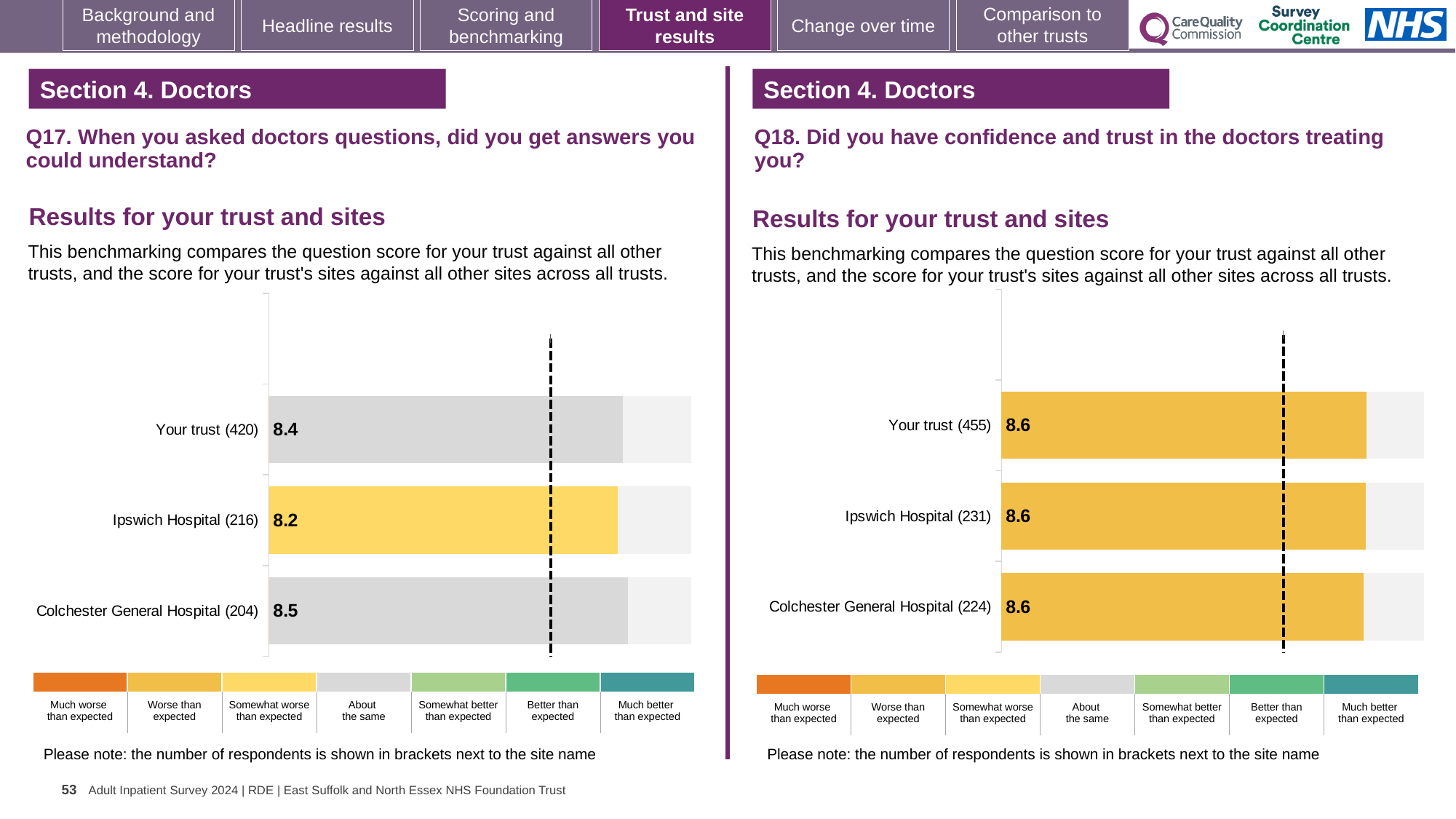
On the Q17 chart (left), which site or trust has the lowest score? Ipswich Hospital On the Q18 chart (right), what is the score for Your trust? 8.6 On the Q17 chart (left), which site or trust has the highest score? Colchester General Hospital On the Q18 chart (right), what is the score for Colchester General Hospital? 8.6 On the Q17 chart (left), what is the score for Ipswich Hospital? 8.2 On the Q17 chart (left), which has the larger score, Your trust or Ipswich Hospital? Your trust On the Q17 chart (left), what is the score for Colchester General Hospital? 8.5 On the Q17 chart (left), what is the difference between the scores for Colchester General Hospital and Ipswich Hospital? 0.3 How many bars are plotted on the Q18 chart (right)? 3 What type of chart is used on the Q17 chart (left)? Bar chart On the Q17 chart (left), how many respondents are shown in brackets for Ipswich Hospital? 216 On the Q17 chart (left), what is the score for Your trust? 8.4